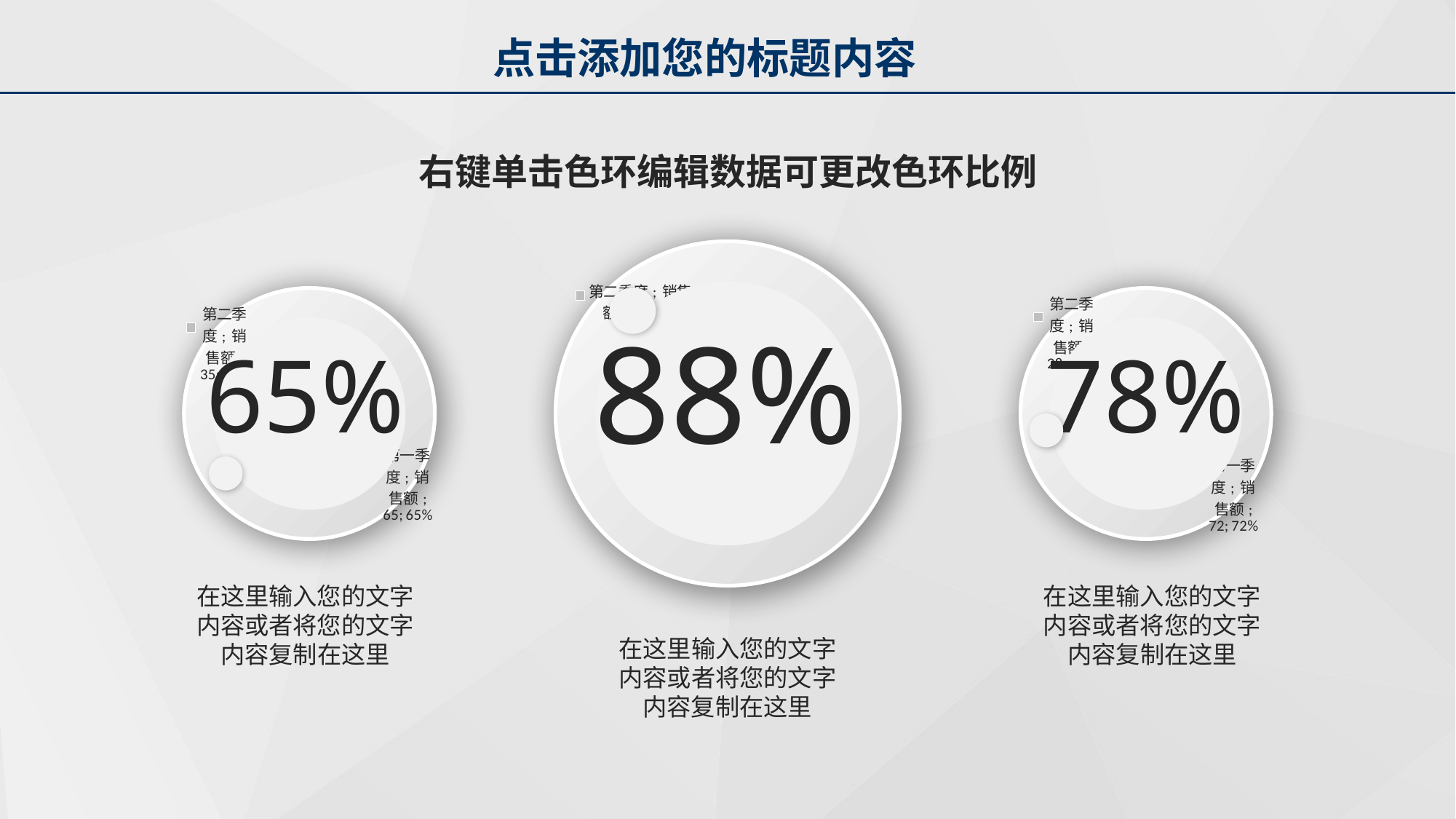
In the right chart, what percentage is shown in the data label for 第一季度 销售额? 72% What kind of chart is each of the three circular graphics on the slide? pie chart What is the difference between the 第一季度 销售额 data label values in the right chart (72) and the left chart (65)? 7 What large percentage is displayed in the centre of the middle chart? 88% Which chart displays the smallest percentage in its centre: the left, middle or right chart? left In the left chart, what value is printed in the data label for 第一季度 销售额 before the percentage? 65 How many circular charts are shown on the slide? 3 Is the 第一季度 销售额 share in the right chart greater or less than the 第一季度 销售额 share in the left chart? greater In the left chart, what percentage is shown in the data label for 第一季度 销售额? 65% Which chart displays the largest percentage in its centre: the left, middle or right chart? middle In the right chart, what value is printed in the data label for 第一季度 销售额 before the percentage? 72 What category name appears in the data labels of the left and right charts alongside 销售额? 第一季度 and 第二季度